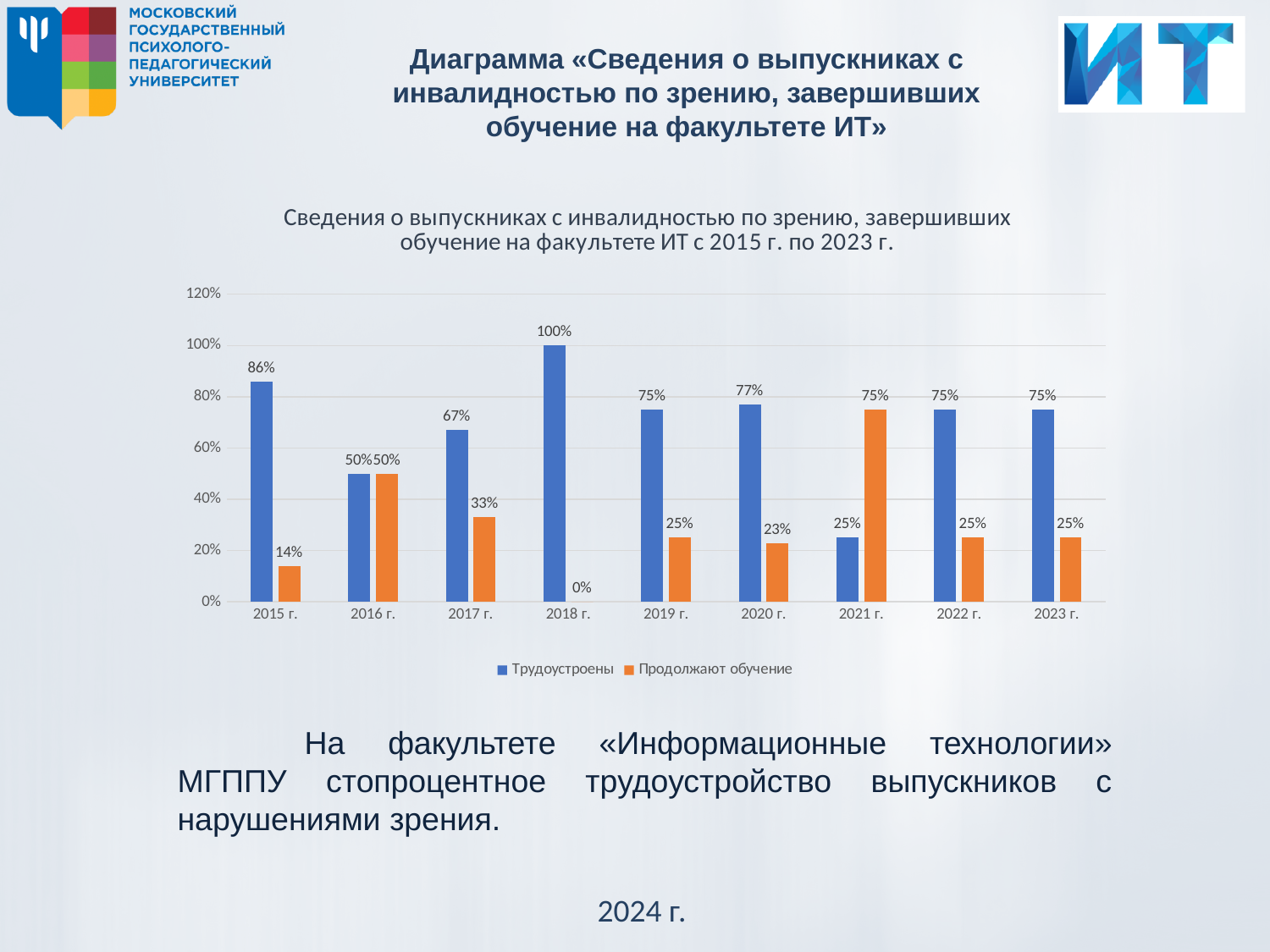
How many series does the legend list? 2 How many years are shown on the x axis? 9 Which is larger in 2021 г., Трудоустроены or Продолжают обучение? Продолжают обучение What is the difference between Трудоустроены and Продолжают обучение in 2015 г.? 72% What is the value for Продолжают обучение in 2018 г.? 0% What kind of chart is shown on the slide? Bar chart What is the value for Трудоустроены in 2020 г.? 77% What is the value for Продолжают обучение in 2017 г.? 33% What is the value for Трудоустроены in 2015 г.? 86% In which year is the value for Трудоустроены the lowest? 2021 г. In which year is the value for Трудоустроены the highest? 2018 г. Which colour represents Продолжают обучение in the legend? Orange